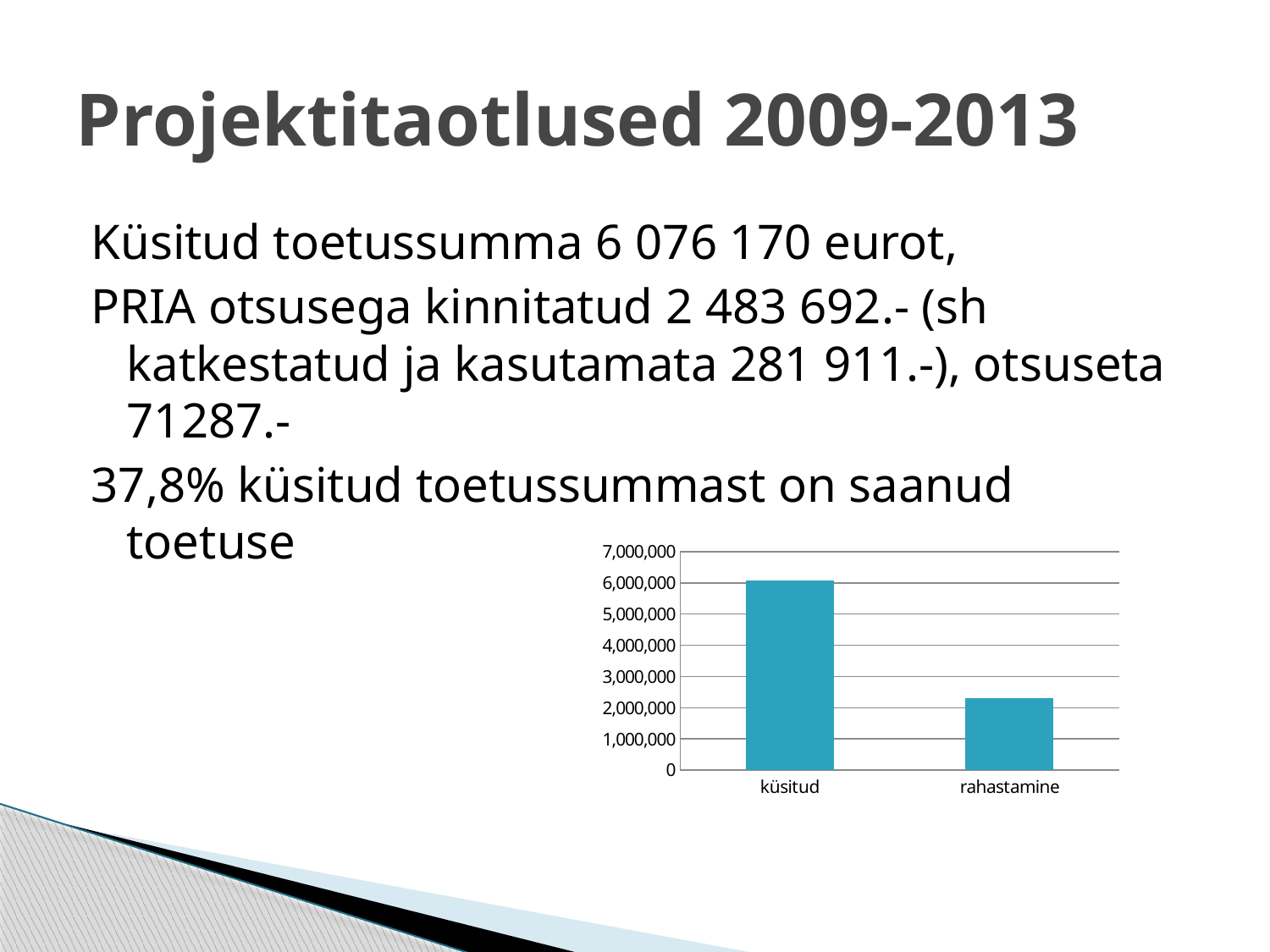
Is the value for küsitud greater or less than 5,000,000? greater Which is larger in the chart, the value for küsitud or the value for rahastamine? küsitud Do the bar values rise or fall from left to right along the x axis? fall What kind of chart is shown on the slide? bar chart Is the value for rahastamine greater or less than 2,000,000? greater What is the highest value labelled on the vertical axis of the chart? 7,000,000 How many categories are shown on the x axis of the chart? 2 Is the value for küsitud greater or less than 7,000,000? less Which category has the lowest bar in the chart? rahastamine What is the label of the second category on the x axis of the chart? rahastamine Which category has the highest bar in the chart? küsitud